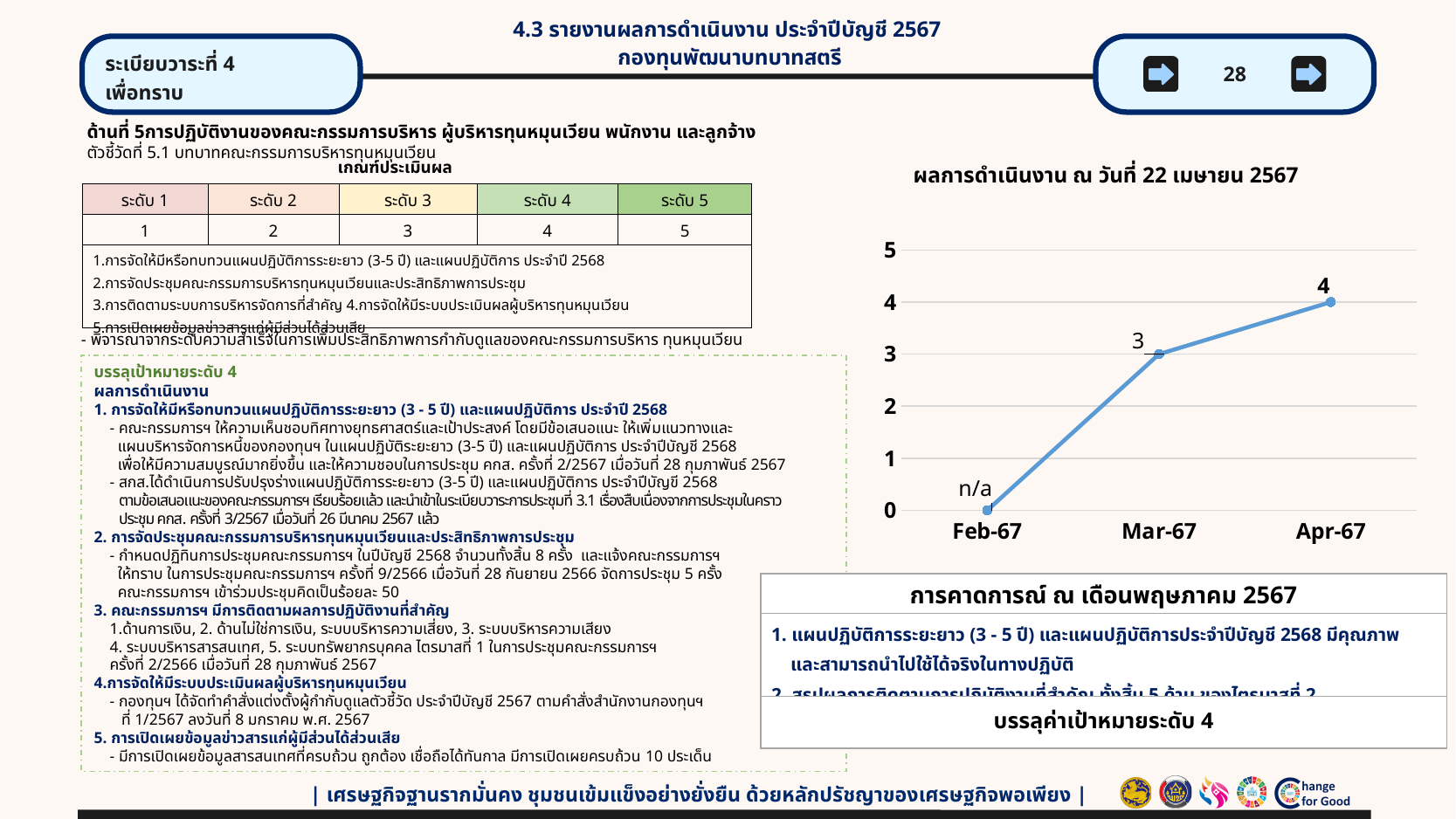
What is the value plotted for Apr-67? 4 Which month has the lowest plotted value? Feb-67 What data label is shown for Feb-67? n/a What is the maximum value shown on the chart's y axis? 5 What type of chart is shown under the title "ผลการดำเนินงาน ณ วันที่ 22 เมษายน 2567"? line chart Which is larger, the value for Mar-67 or the value for Apr-67? Apr-67 Do the plotted values rise or fall from Feb-67 to Apr-67? rise Which month has the highest plotted value? Apr-67 Is the value for Apr-67 greater or less than 5? less How many months are plotted on the x axis of the chart? 3 What is the value plotted for Mar-67? 3 What is the difference between the values for Apr-67 and Mar-67? 1